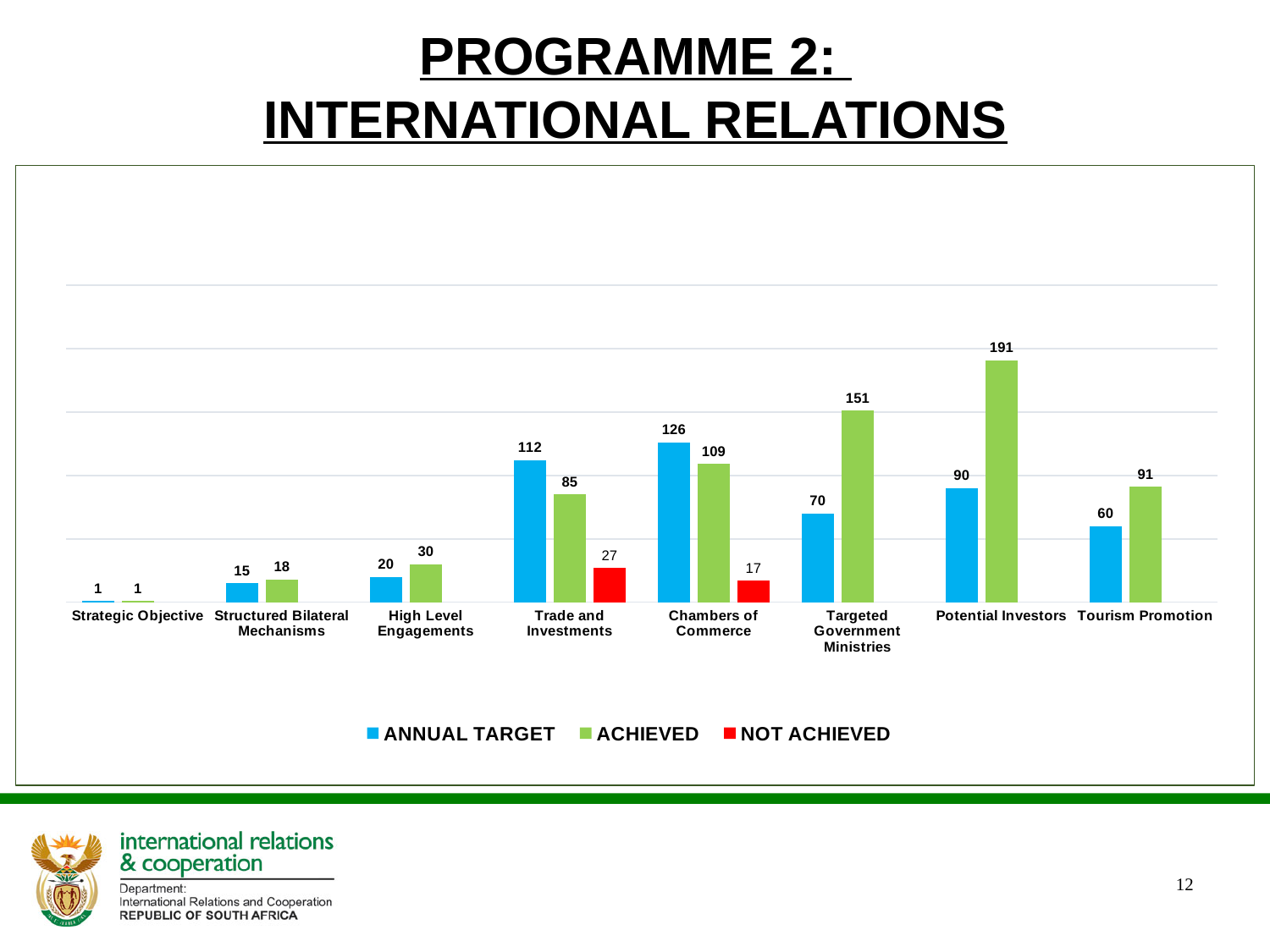
Which colour represents the NOT ACHIEVED series in the legend? Red What is the difference between the ANNUAL TARGET and ACHIEVED values for Tourism Promotion? 31 Which category has the lowest ANNUAL TARGET value? Strategic Objective What kind of chart is shown on the slide? Bar chart How many series does the legend list? 3 What is the ANNUAL TARGET value for Trade and Investments? 112 How many categories are shown on the x axis? 8 What is the ACHIEVED value for Targeted Government Ministries? 151 Which category has the highest ACHIEVED value? Potential Investors What is the ACHIEVED value for Potential Investors? 191 What is the NOT ACHIEVED value for Chambers of Commerce? 17 Which is larger for Chambers of Commerce, the ANNUAL TARGET or the ACHIEVED value? ANNUAL TARGET